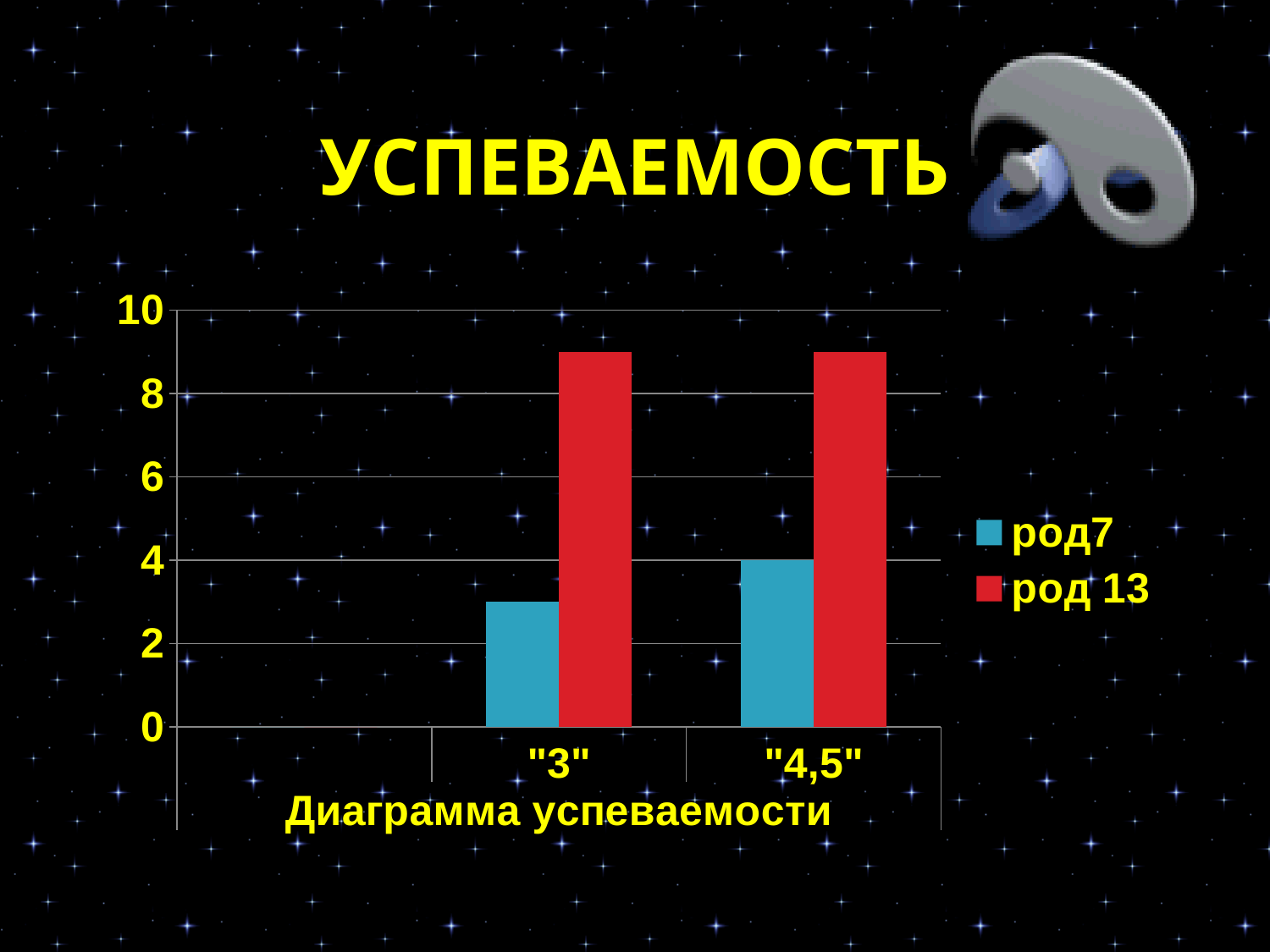
Does the value for род7 rise or fall from "3" to "4,5"? rise Is the value for род 13 in the "4,5" category greater or less than 10? less What is the title shown below the x axis of the chart? Диаграмма успеваемости What is the value for род7 in the "4,5" category? 4 What colour are the bars for род 13? red What kind of chart is shown on the slide? bar chart How many series does the legend list? 2 Which series has the larger value in the "3" category, род7 or род 13? род 13 Is the value for род 13 in the "3" category greater or less than 8? greater How many categories are shown on the x axis? 2 Is the value for род7 in the "3" category greater or less than 4? less For род7, which category has the higher value? "4,5"